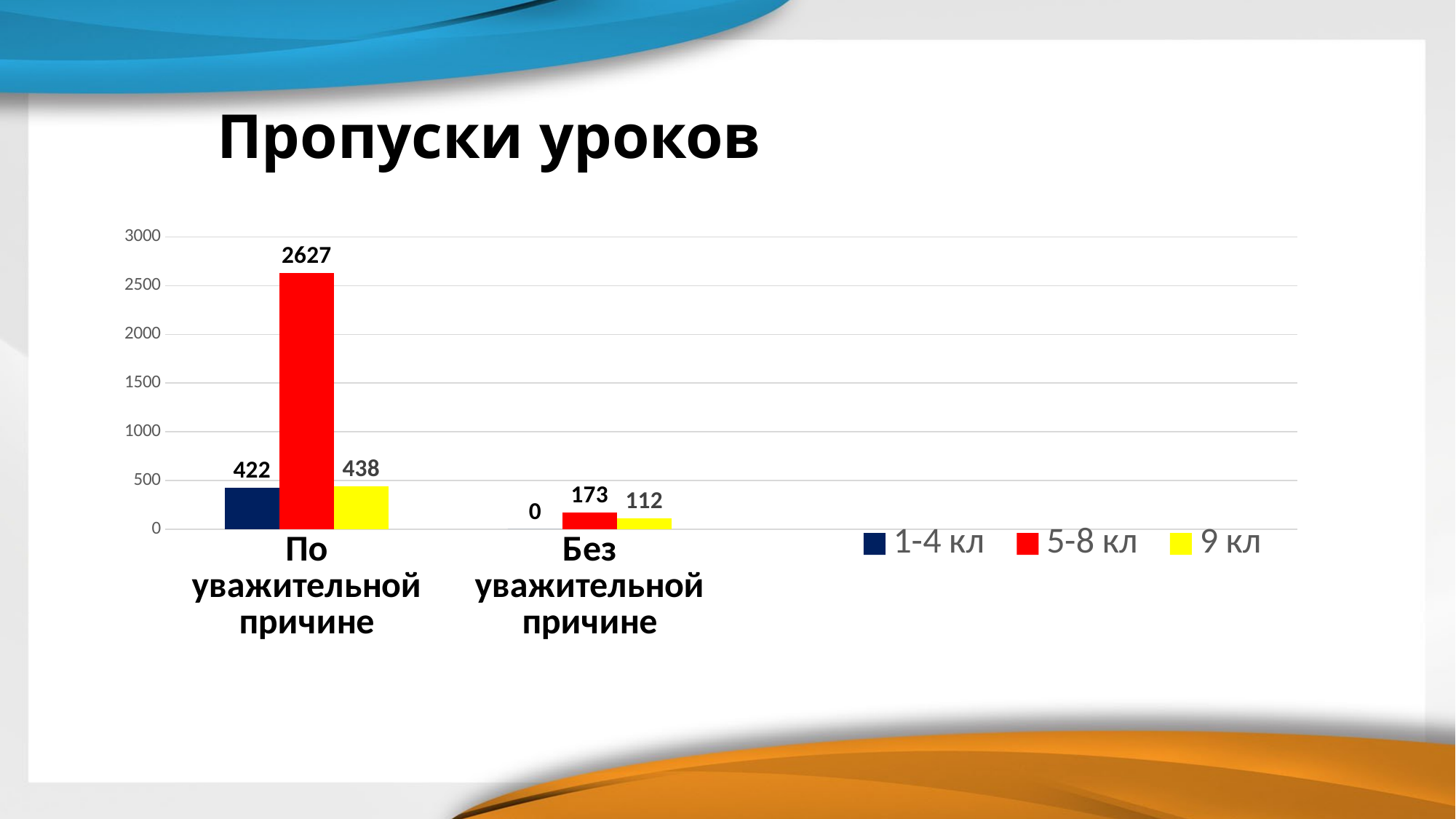
What is the value for 1-4 кл in the 'Без уважительной причине' category? 0 Which series has the lowest value in the 'Без уважительной причине' category? 1-4 кл What is the value for 5-8 кл in the 'Без уважительной причине' category? 173 Is the value for 5-8 кл in 'По уважительной причине' greater or less than 2500? greater How many series does the legend list? 3 How many categories are shown on the x axis? 2 What kind of chart is shown on the slide? bar chart What is the difference between the 5-8 кл values for 'По уважительной причине' and 'Без уважительной причине'? 2454 Which series has the highest value in the 'По уважительной причине' category? 5-8 кл What is the value for 9 кл in the 'По уважительной причине' category? 438 What is the value for 5-8 кл in the 'По уважительной причине' category? 2627 Which is larger in the 'По уважительной причине' category: the value for 1-4 кл or for 9 кл? 9 кл